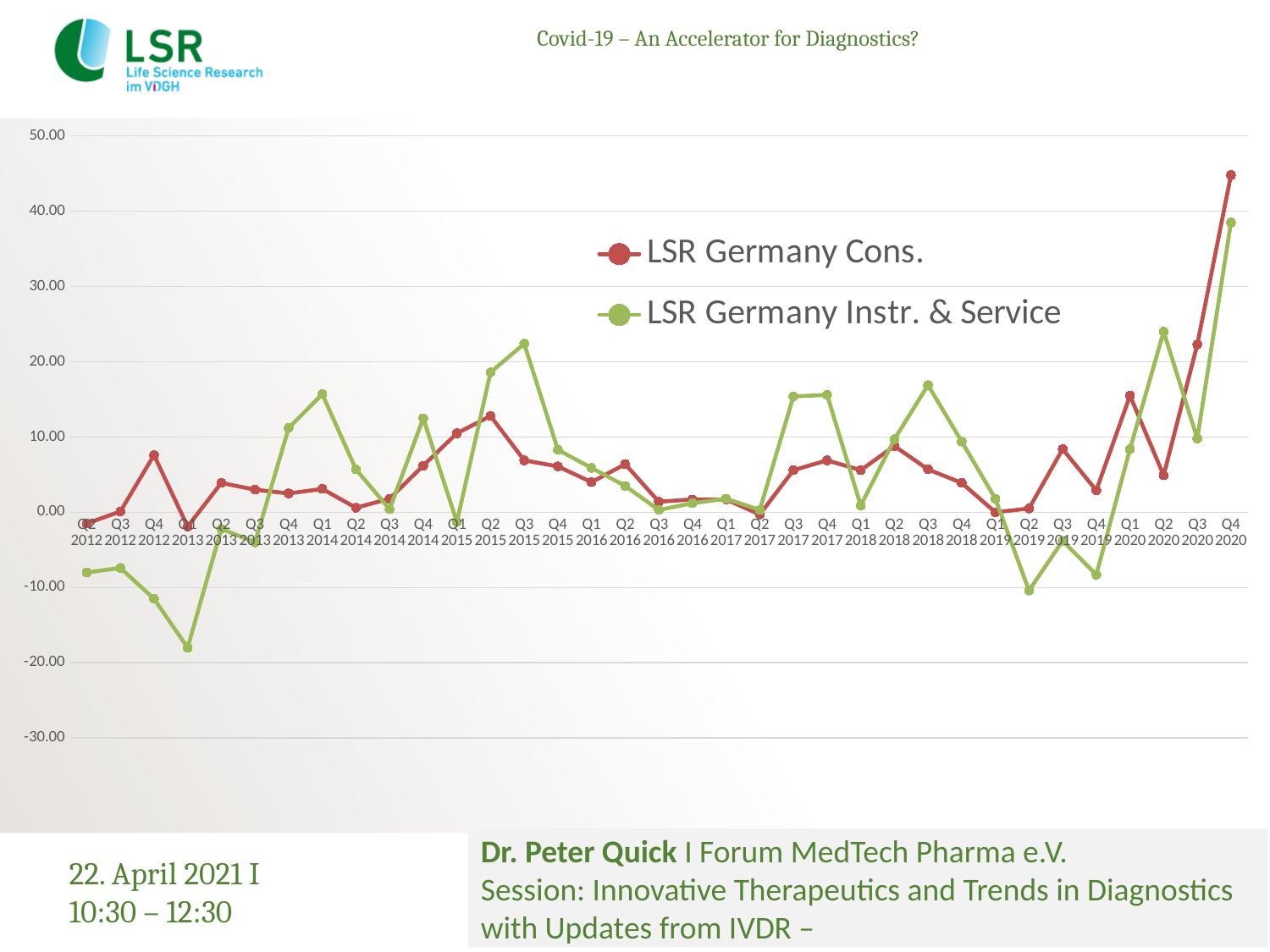
What kind of chart is shown on the slide? Line chart How many series does the legend list? 2 Does the LSR Germany Cons. line rise or fall from Q2 2020 to Q4 2020? Rise In Q3 2015, which series has the higher value, LSR Germany Cons. or LSR Germany Instr. & Service? LSR Germany Instr. & Service Is the value for LSR Germany Instr. & Service in Q1 2013 greater or less than -10.00? less In which quarter does LSR Germany Cons. reach its highest value? Q4 2020 Which colour is used for the LSR Germany Instr. & Service series? Green Is the value for LSR Germany Instr. & Service in Q3 2015 greater or less than 20.00? greater Is the value for LSR Germany Cons. in Q4 2020 greater or less than 40.00? greater In Q4 2020, which series has the higher value, LSR Germany Cons. or LSR Germany Instr. & Service? LSR Germany Cons. How many quarterly data points are plotted along the x axis for each series? 35 In which quarter does LSR Germany Instr. & Service reach its lowest value? Q1 2013